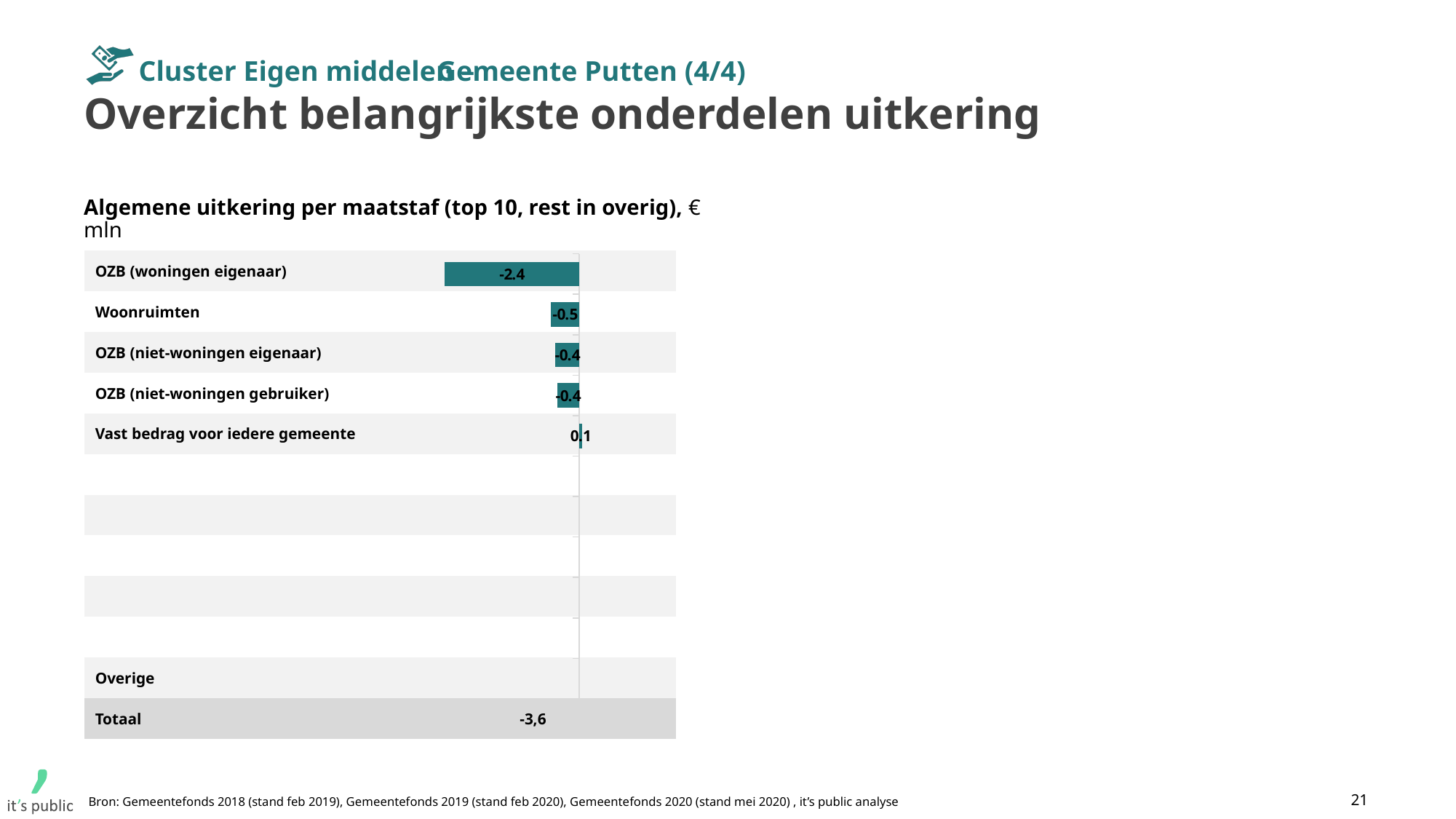
Which category is the only one with a positive value? Vast bedrag voor iedere gemeente Which category has the most negative value? OZB (woningen eigenaar) What is the value for OZB (niet-woningen gebruiker)? -0.4 In what unit are the values in the chart expressed? € mln What is the value for OZB (woningen eigenaar)? -2.4 What is the value shown for Totaal? -3,6 What kind of chart is shown on the slide? Bar chart How many categories have a negative value plotted? 4 What is the value for Woonruimten? -0.5 What is the title of the chart? Algemene uitkering per maatstaf (top 10, rest in overig), € mln What is the difference between the values for OZB (woningen eigenaar) and Woonruimten? 1.9 Which has the larger negative value, Woonruimten or OZB (niet-woningen eigenaar)? Woonruimten